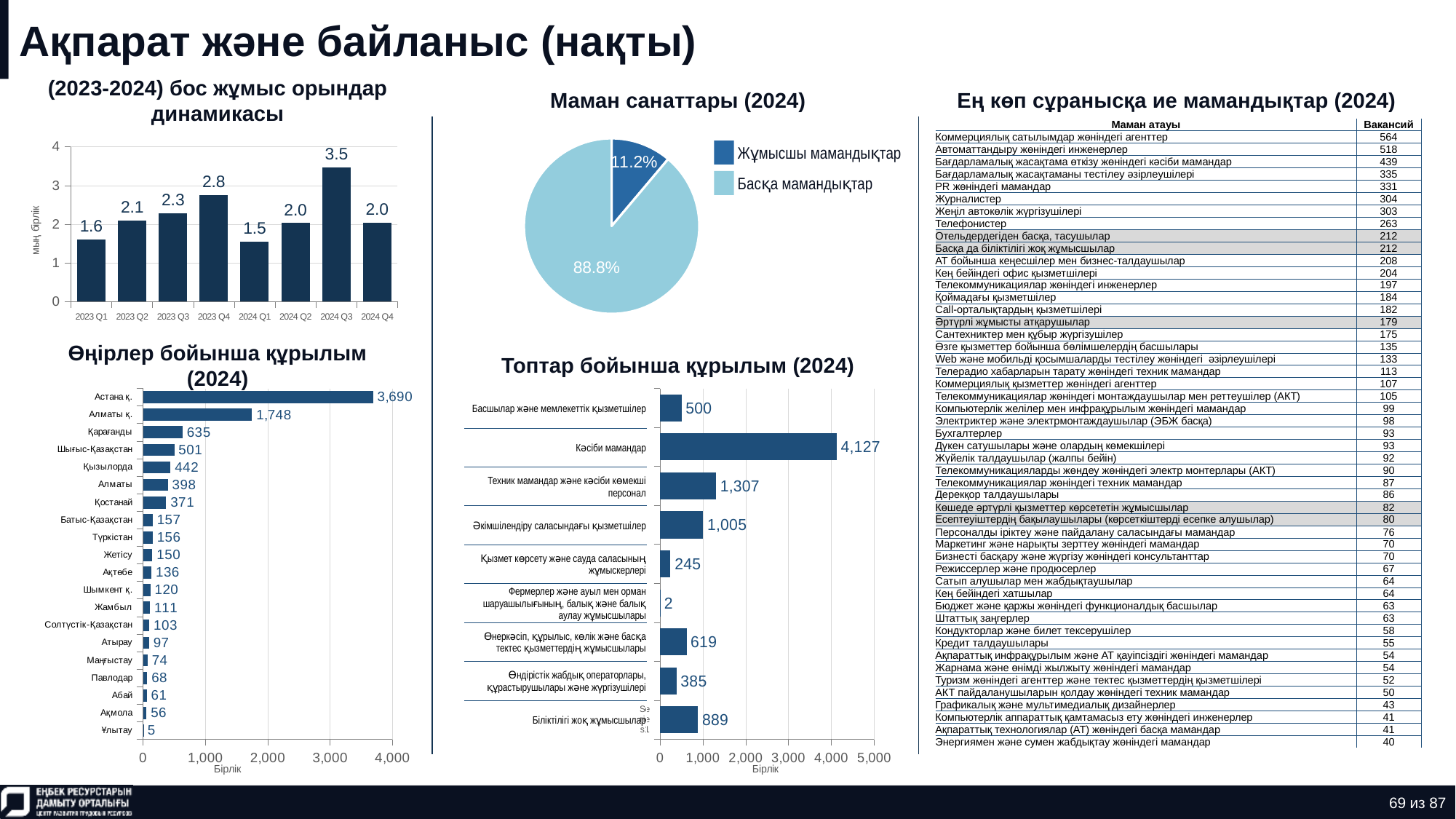
How many entries does the legend of the pie chart "Маман санаттары (2024)" list? 2 What type of chart is "Топтар бойынша құрылым (2024)"? Bar chart In the chart "Өңірлер бойынша құрылым (2024)", which is larger: Қарағанды or Шығыс-Қазақстан? Қарағанды In the chart "Өңірлер бойынша құрылым (2024)", which region has the highest value? Астана қ. In the pie chart "Маман санаттары (2024)", what share does "Жұмысшы мамандықтар" have? 11.2% In the chart "Топтар бойынша құрылым (2024)", what is the value for "Кәсіби мамандар"? 4,127 In the chart "Өңірлер бойынша құрылым (2024)", what is the value for Алматы қ.? 1,748 In the chart "(2023-2024) бос жұмыс орындар динамикасы", which quarter has the lowest value? 2024 Q1 In the chart "(2023-2024) бос жұмыс орындар динамикасы", what is the difference between 2024 Q3 and 2024 Q4? 1.5 In the chart "(2023-2024) бос жұмыс орындар динамикасы", what is the value for 2024 Q3? 3.5 In the chart "(2023-2024) бос жұмыс орындар динамикасы", how many quarters are plotted? 8 In the chart "Өңірлер бойынша құрылым (2024)", which region has the lowest value? Ұлытау